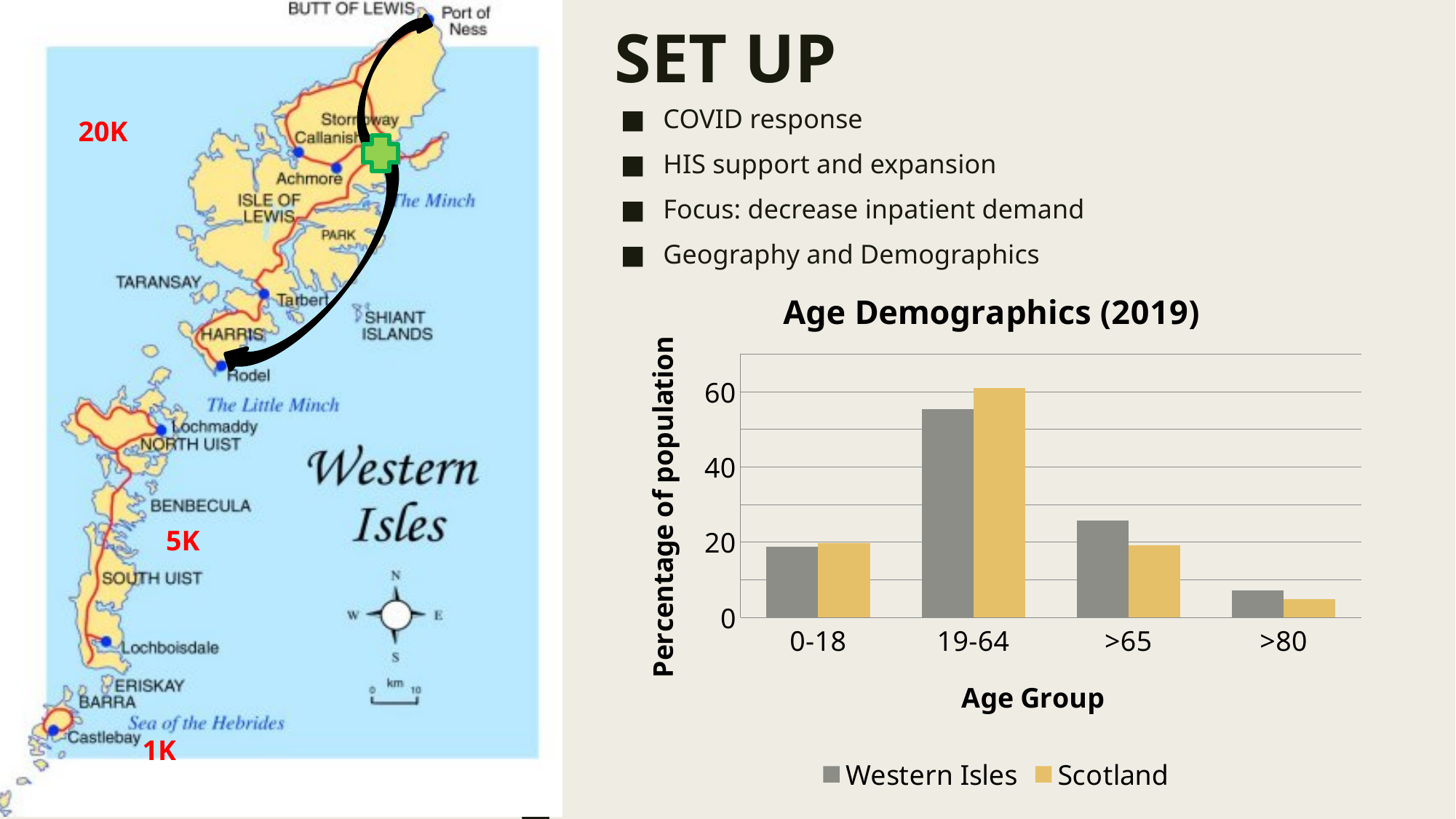
In the Age Demographics (2019) chart, for the >65 age group, which is larger: Western Isles or Scotland? Western Isles In the Age Demographics (2019) chart, which age group has the highest value for Western Isles? 19-64 How many series does the legend of the Age Demographics (2019) chart list? 2 How many age groups are shown on the x axis of the Age Demographics (2019) chart? 4 What type of chart is shown under the title "Age Demographics (2019)"? bar chart In the Age Demographics (2019) chart, which series is shown in grey? Western Isles In the Age Demographics (2019) chart, which age group has the lowest value for Scotland? >80 In the Age Demographics (2019) chart, is the Western Isles value for the >65 age group greater or less than 20? greater In the Age Demographics (2019) chart, for the 19-64 age group, which is larger: Western Isles or Scotland? Scotland In the Age Demographics (2019) chart, is the Scotland value for the >80 age group greater or less than 20? less In the Age Demographics (2019) chart, is the Western Isles value for the 19-64 age group greater or less than 40? greater What is the label on the y axis of the Age Demographics (2019) chart? Percentage of population